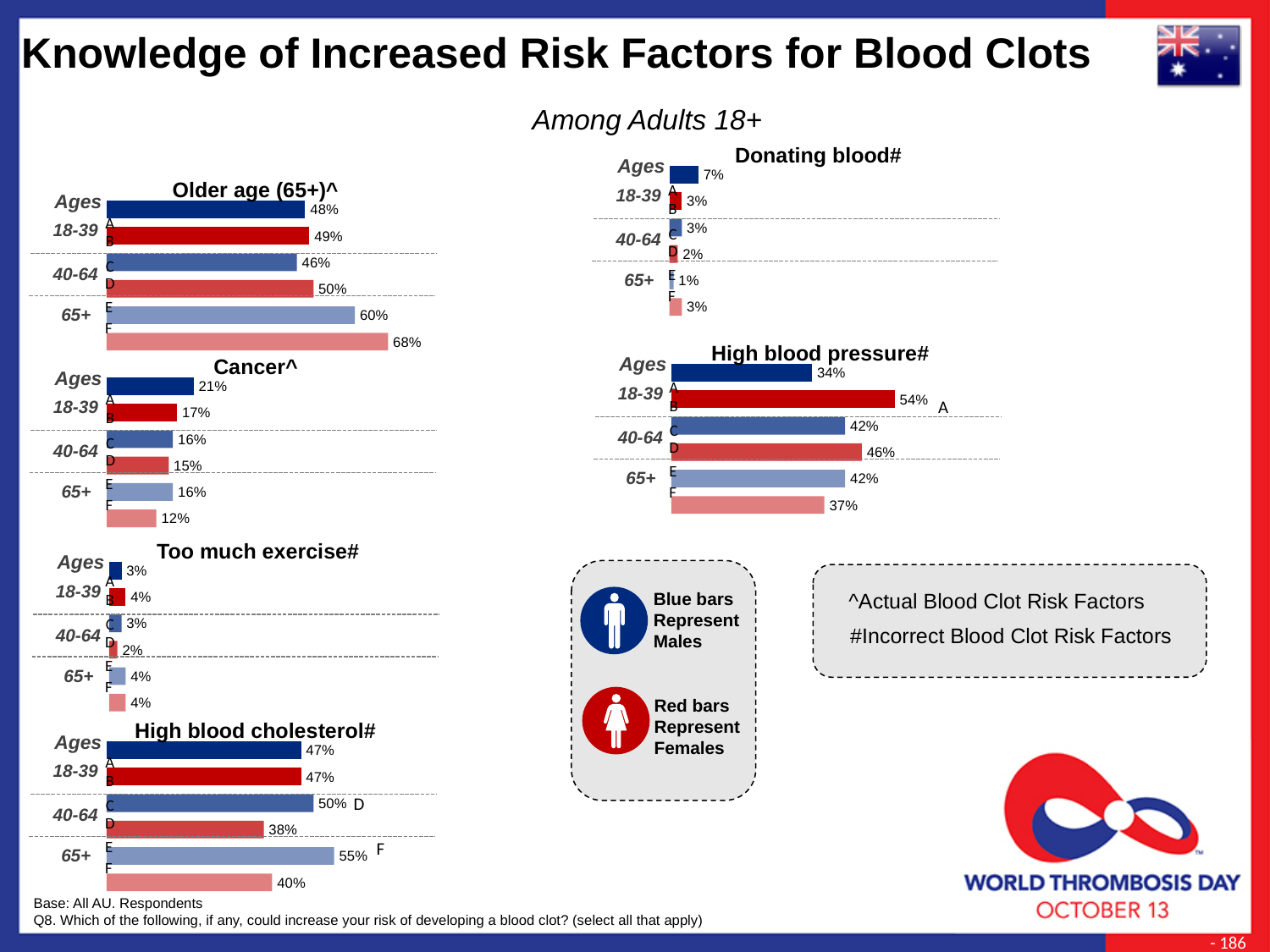
In the 'Too much exercise#' chart, what is the value for females aged 40-64 (bar D)? 2% In the 'Donating blood#' chart, what is the value for males aged 18-39 (bar A)? 7% In the 'Older age (65+)^' chart, what is the value for females aged 65+ (bar F)? 68% In the 'High blood cholesterol#' chart, which is larger: males aged 65+ (bar E) or females aged 65+ (bar F)? Males aged 65+ (E), 55% In the 'High blood pressure#' chart, what is the difference between females aged 18-39 (bar B) and males aged 18-39 (bar A)? 20 percentage points What type of chart is used for 'High blood pressure#'? Bar chart In the 'Cancer^' chart, what is the value for males aged 18-39 (bar A)? 21% According to the legend box, what do the blue bars represent? Males In the 'Donating blood#' chart, which bar has the lowest value? E (males 65+), 1% In the 'Older age (65+)^' chart, which bar has the highest value? F (females 65+), 68% How many bars does the 'High blood cholesterol#' chart show? 6 In the 'Cancer^' chart, which bar has the lowest value? F (females 65+), 12%